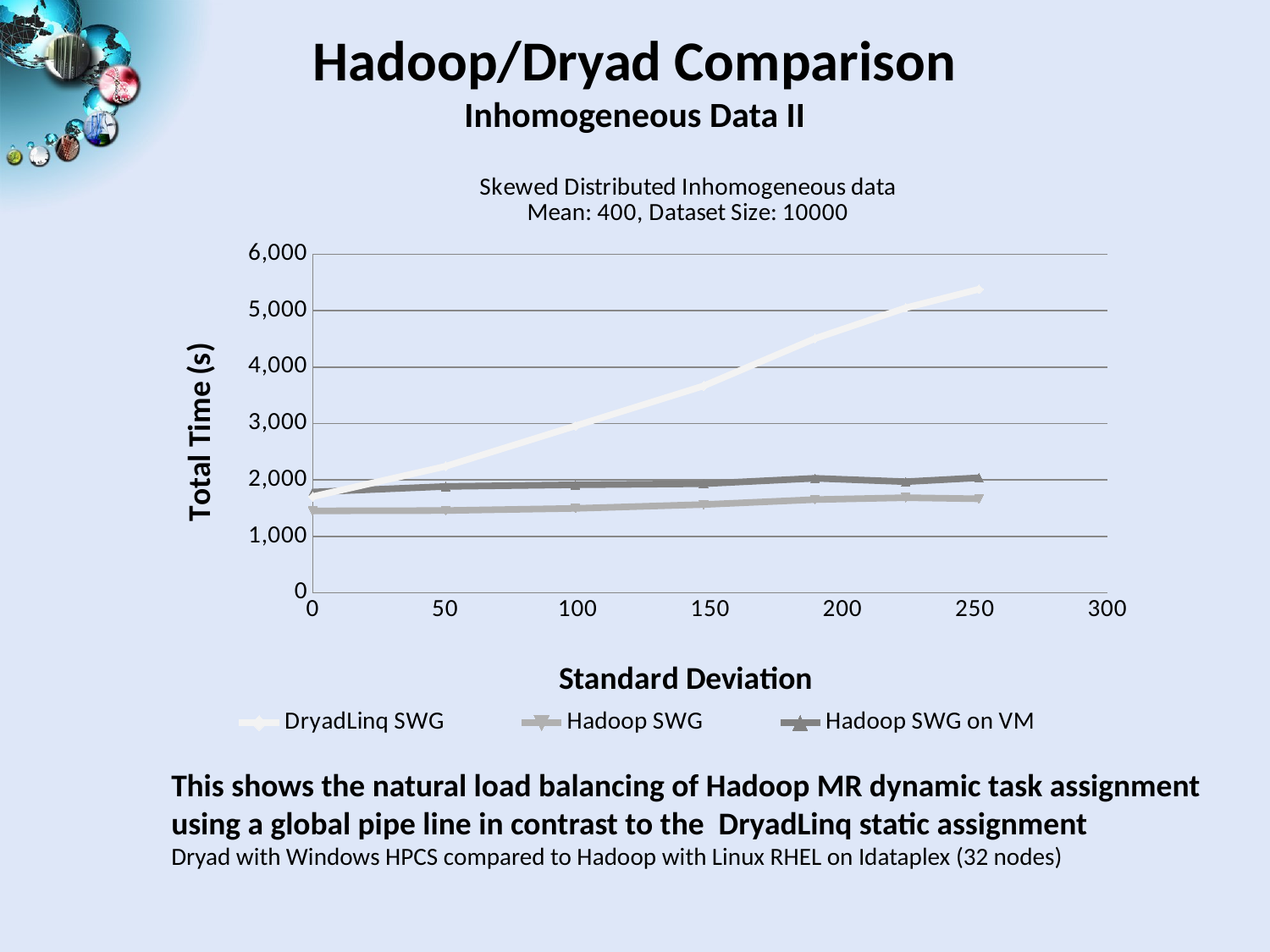
Is the value for DryadLinq SWG at a standard deviation of 200 greater or less than 4,000? greater Is the value for DryadLinq SWG at a standard deviation of 250 greater or less than 5,000? greater Is the value for Hadoop SWG at a standard deviation of 0 greater or less than 2,000? less What is the title of the chart? Skewed Distributed Inhomogeneous data Mean: 400, Dataset Size: 10000 What kind of chart is shown on the slide? line chart Which series has the highest total time at a standard deviation of 250? DryadLinq SWG Does the DryadLinq SWG line rise or fall as Standard Deviation increases? rise At a standard deviation of 250, which is larger: DryadLinq SWG or Hadoop SWG? DryadLinq SWG How many series does the legend list? 3 Which series has the lowest total time at a standard deviation of 100? Hadoop SWG What is the label of the y axis? Total Time (s)